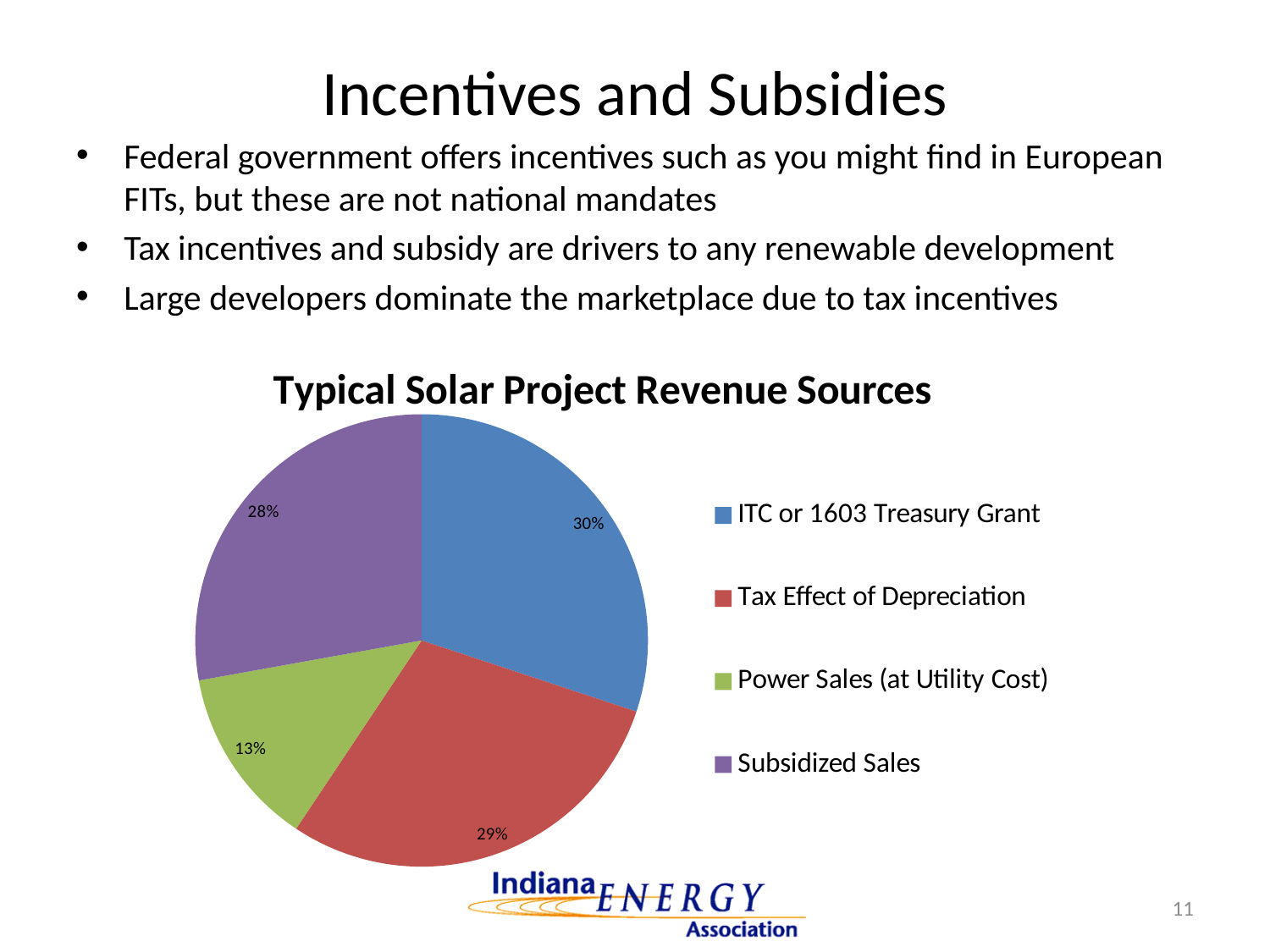
How many slices does the pie chart have? 4 What share of the pie is ITC or 1603 Treasury Grant? 30% What is the title of the chart? Typical Solar Project Revenue Sources Which colour represents Subsidized Sales in the legend? purple Which revenue source has the smallest share of the pie? Power Sales (at Utility Cost) What share of the pie is Tax Effect of Depreciation? 29% Which is larger, the share for Subsidized Sales or the share for Power Sales (at Utility Cost)? Subsidized Sales What share of the pie is Power Sales (at Utility Cost)? 13% Which revenue source has the largest share of the pie? ITC or 1603 Treasury Grant What kind of chart is shown on the slide? pie chart What is the difference in percentage points between Subsidized Sales and Power Sales (at Utility Cost)? 15